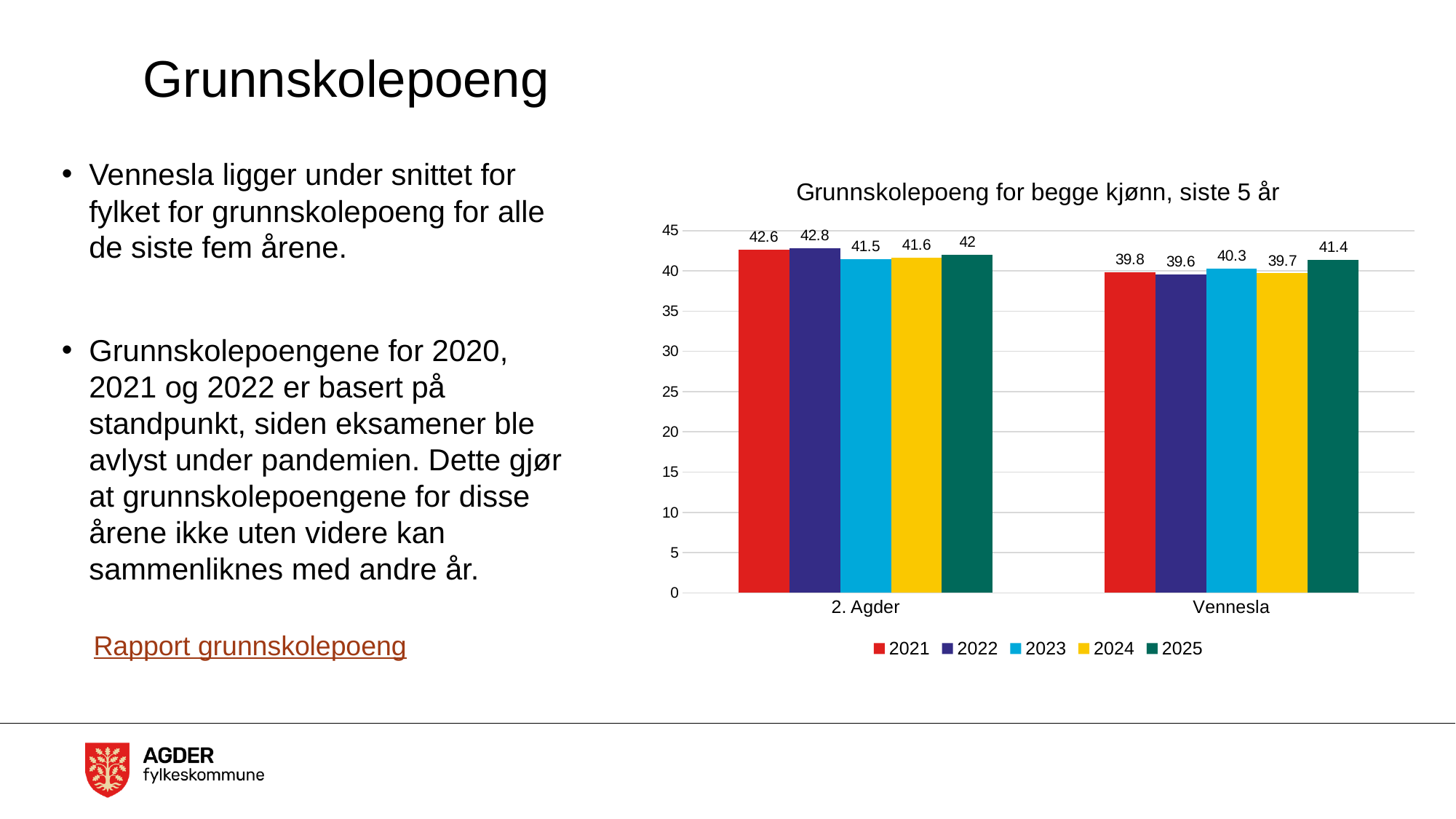
Which is larger, the 2025 value for 2. Agder or the 2025 value for Vennesla? 2. Agder What is the value for Vennesla in 2025? 41.4 How many categories are shown on the x axis? 2 Which year has the lowest value for Vennesla? 2022 How many series does the legend list? 5 Is the value for Vennesla in 2022 greater or less than 40? less What is the title of the chart? Grunnskolepoeng for begge kjønn, siste 5 år What kind of chart is shown? bar chart What is the difference between the 2. Agder and Vennesla values in 2024? 1.9 What is the value for Vennesla in 2023? 40.3 What is the value for 2. Agder in 2021? 42.6 Which year has the highest value for 2. Agder? 2022